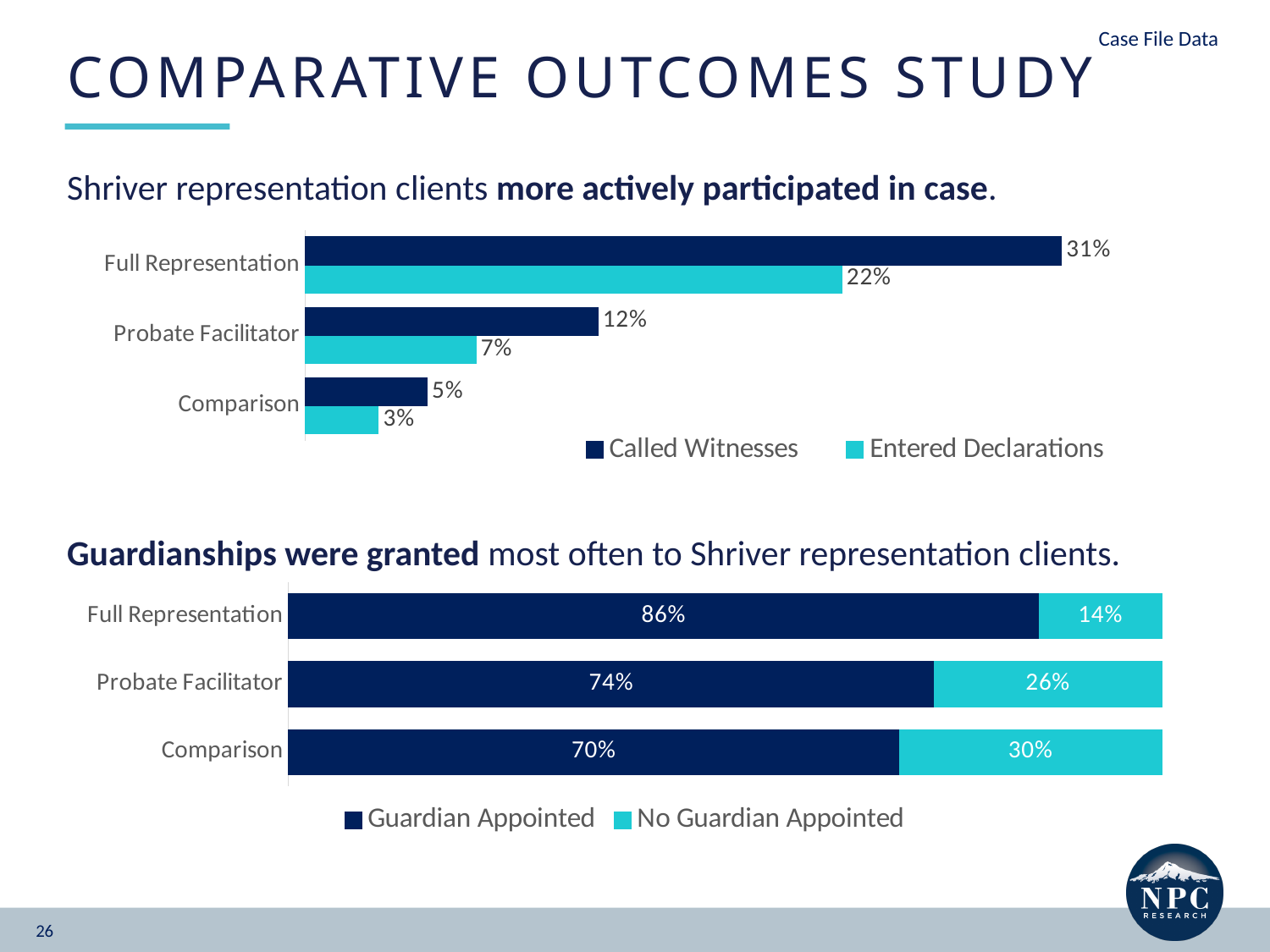
In the top chart, which group has the lowest Called Witnesses value? Comparison In the bottom chart, what is the total of the Probate Facilitator bar? 100% How many series does the legend of the top chart list? 2 In the bottom chart, what percentage of Comparison cases had a guardian appointed? 70% In the bottom chart, which group has the highest Guardian Appointed value? Full Representation What kind of chart is the bottom chart? Stacked bar chart How many categories are shown in the bottom chart? 3 In the top chart, what percentage of Full Representation clients called witnesses? 31% In the top chart, which is larger: the Entered Declarations value for Full Representation or the Called Witnesses value for Probate Facilitator? Entered Declarations for Full Representation In the top chart, what is the difference between the Called Witnesses and Entered Declarations values for Full Representation? 9% In the top chart, what is the Entered Declarations value for Probate Facilitator? 7% In the bottom chart, what is the difference between the No Guardian Appointed values for Comparison and Full Representation? 16%